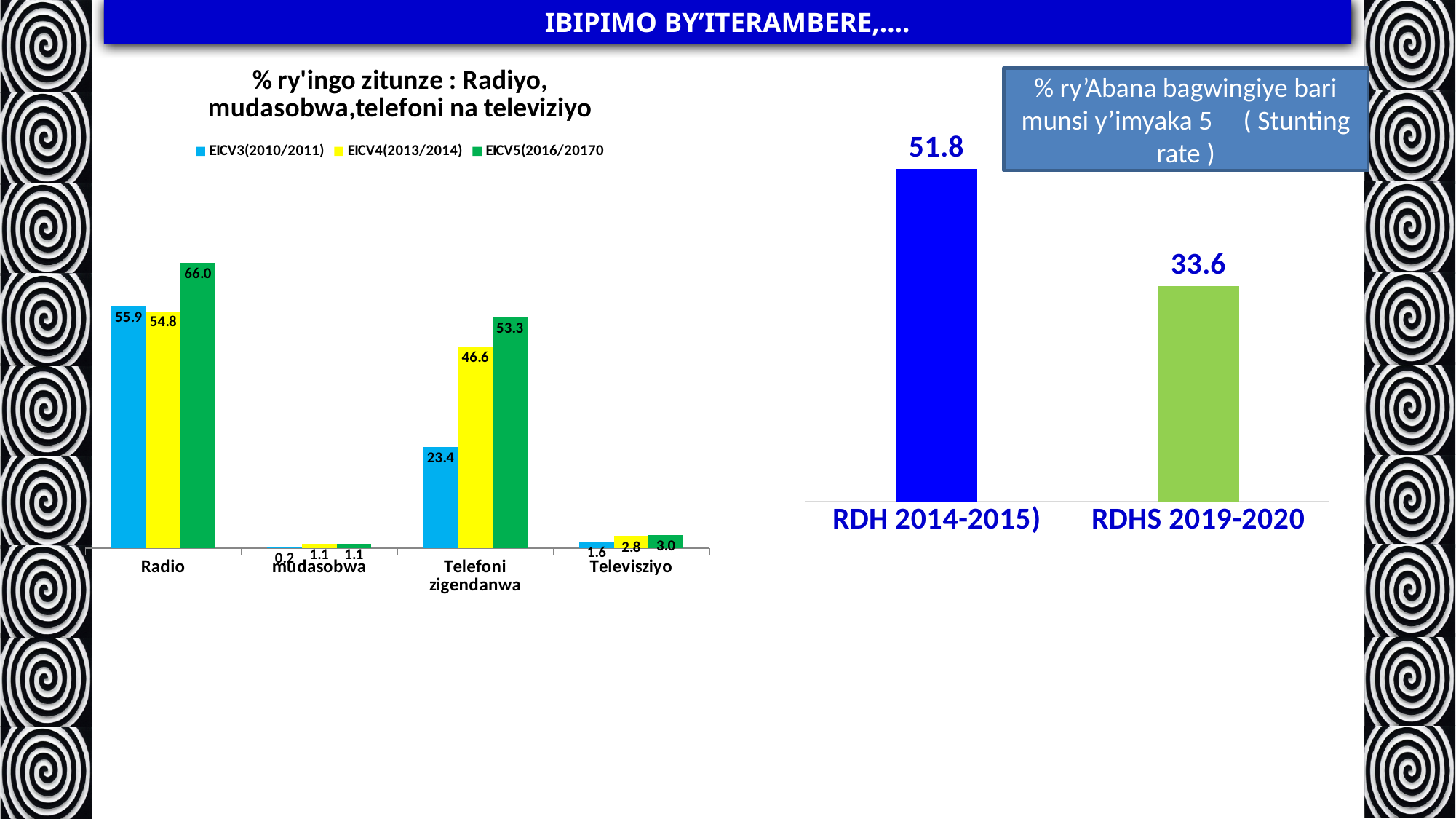
In the left chart (% ry'ingo zitunze), how many categories are shown on the x axis? 4 In the left chart (% ry'ingo zitunze), which category has the lowest EICV3(2010/2011) value? mudasobwa In the left chart (% ry'ingo zitunze), how many series does the legend list? 3 In the left chart (% ry'ingo zitunze), what is the EICV4(2013/2014) value for Televisziyo? 2.8 What kind of chart is the right chart (Stunting rate)? Bar chart In the left chart (% ry'ingo zitunze), what is the EICV3(2010/2011) value for Telefoni zigendanwa? 23.4 In the left chart (% ry'ingo zitunze), which category has the highest EICV5(2016/20170 value? Radio In the right chart (Stunting rate), what is the difference between the RDH 2014-2015 value and the RDHS 2019-2020 value? 18.2 In the left chart (% ry'ingo zitunze), what is the EICV5(2016/20170 value for Radio? 66.0 In the left chart (% ry'ingo zitunze), what is the difference between the EICV5(2016/20170 and EICV3(2010/2011) values for Telefoni zigendanwa? 29.9 In the left chart (% ry'ingo zitunze), which is larger for Radio: the EICV3(2010/2011) value or the EICV4(2013/2014) value? EICV3(2010/2011) In the right chart (Stunting rate), what is the value for RDHS 2019-2020? 33.6